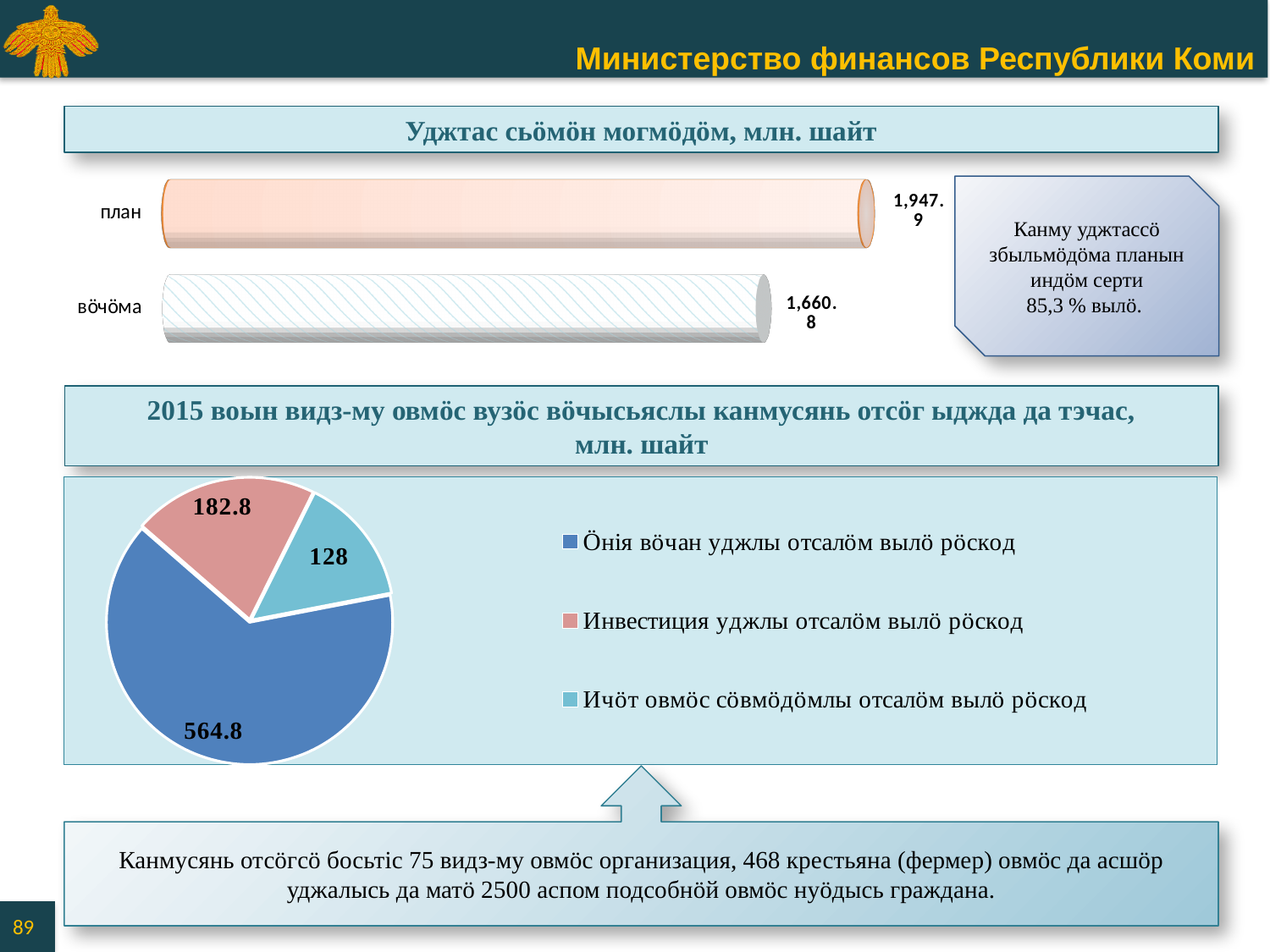
In the pie chart at the bottom of the slide, what is the value for Öнія вöчан уджлы отсалöм вылö рöскод? 564.8 How many entries does the legend of the pie chart at the bottom of the slide list? 3 In the pie chart at the bottom of the slide, what is the value for Инвестиция уджлы отсалöм вылö рöскод? 182.8 In the pie chart at the bottom of the slide, what is the value for Ичöт овмöс сöвмöдöмлы отсалöм вылö рöскод? 128 In the pie chart at the bottom of the slide, which category has the largest slice? Öнія вöчан уджлы отсалöм вылö рöскод In the pie chart at the bottom of the slide, what is the difference between the values 564.8 and 182.8? 382 In the pie chart at the bottom of the slide, which category has the smallest slice? Ичöт овмöс сöвмöдöмлы отсалöм вылö рöскод In the bar chart at the top of the slide, what is the value for вöчöма? 1,660.8 In the bar chart at the top of the slide, what is the difference between план and вöчöма? 287.1 In the bar chart at the top of the slide (Уджтас сьöмöн могмöдöм, млн. шайт), what is the value for план? 1,947.9 In the bar chart at the top of the slide, which category has the larger value, план or вöчöма? план What kind of chart is shown at the top of the slide under the title Уджтас сьöмöн могмöдöм? bar chart